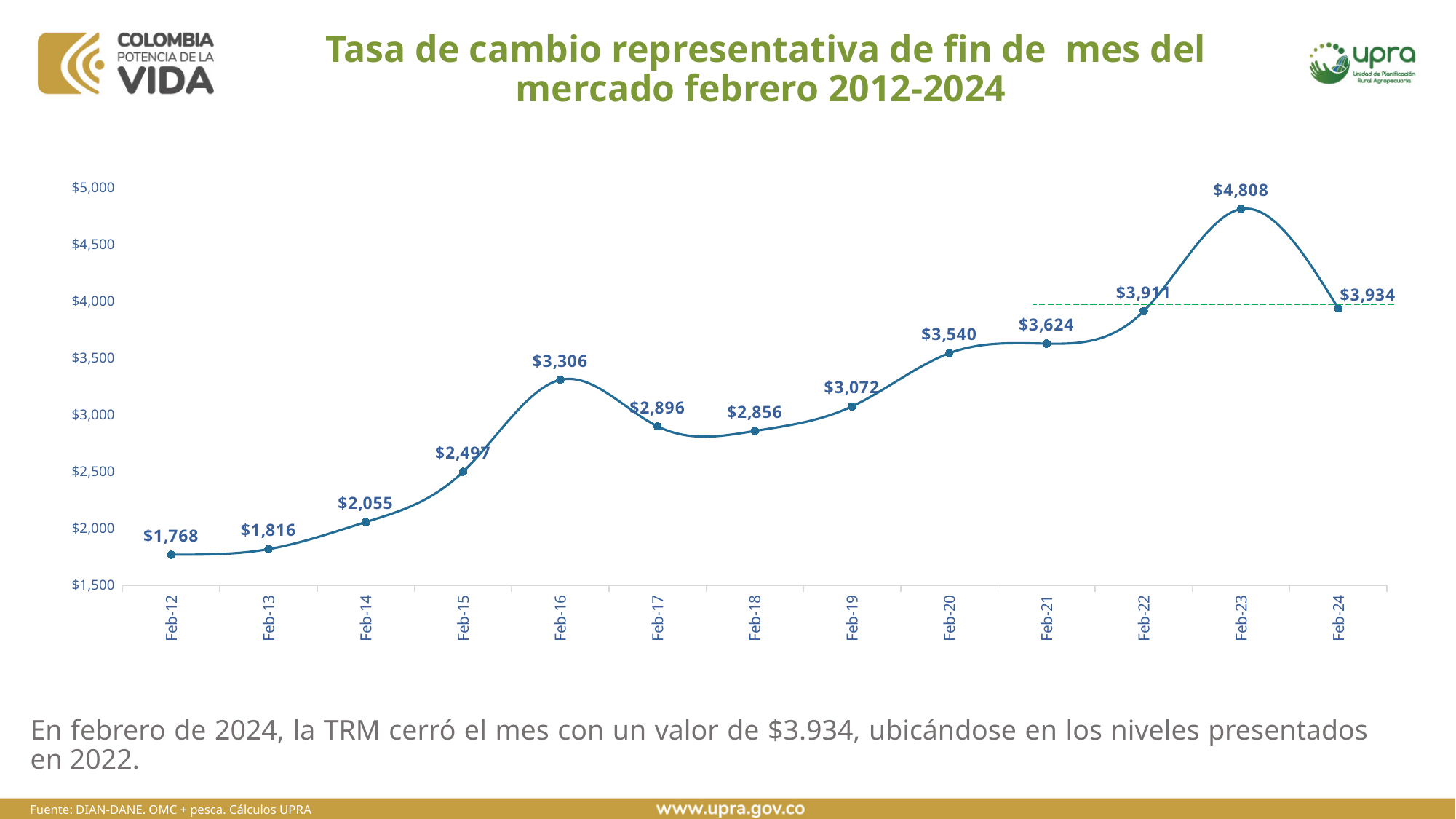
How many data points are plotted on the chart? 13 What is the difference between the values for Feb-23 and Feb-24? $874 What is the value for Feb-16? $3,306 What is the value for Feb-12? $1,768 Which is larger, the value for Feb-17 or the value for Feb-18? Feb-17 Is the value for Feb-20 greater or less than $3,500? greater What is the value for Feb-24? $3,934 Which point has the highest value? Feb-23 Which point has the lowest value? Feb-12 Do the values rise or fall from Feb-12 to Feb-16? rise What kind of chart is shown on the slide? line chart What is the title of the chart? Tasa de cambio representativa de fin de mes del mercado febrero 2012-2024